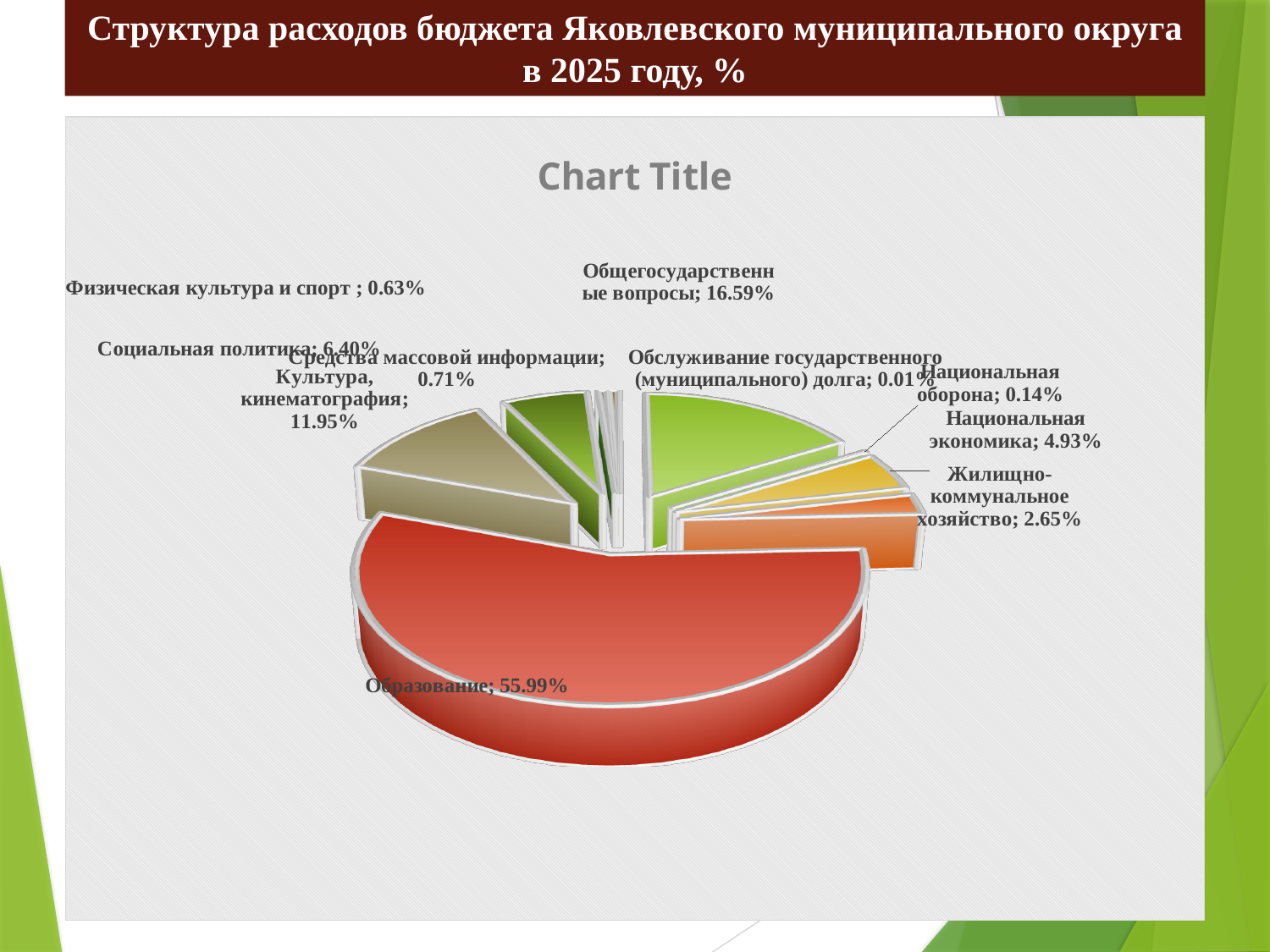
Which is larger, Социальная политика or Национальная экономика? Социальная политика What is the title shown above the pie chart? Chart Title What share of the budget expenditure goes to Образование? 55.99% Which category has the largest share of the pie? Образование Which category has the smallest share of the pie? Обслуживание государственного (муниципального) долга What is the value for Национальная экономика? 4.93% How many categories are shown in the pie chart? 10 What is the difference between the shares of Образование and Общегосударственные вопросы? 39.40% What is the value for Общегосударственные вопросы? 16.59% What is the value for Культура, кинематография? 11.95% What is the value for Жилищно-коммунальное хозяйство? 2.65% What kind of chart is shown on the slide? pie chart